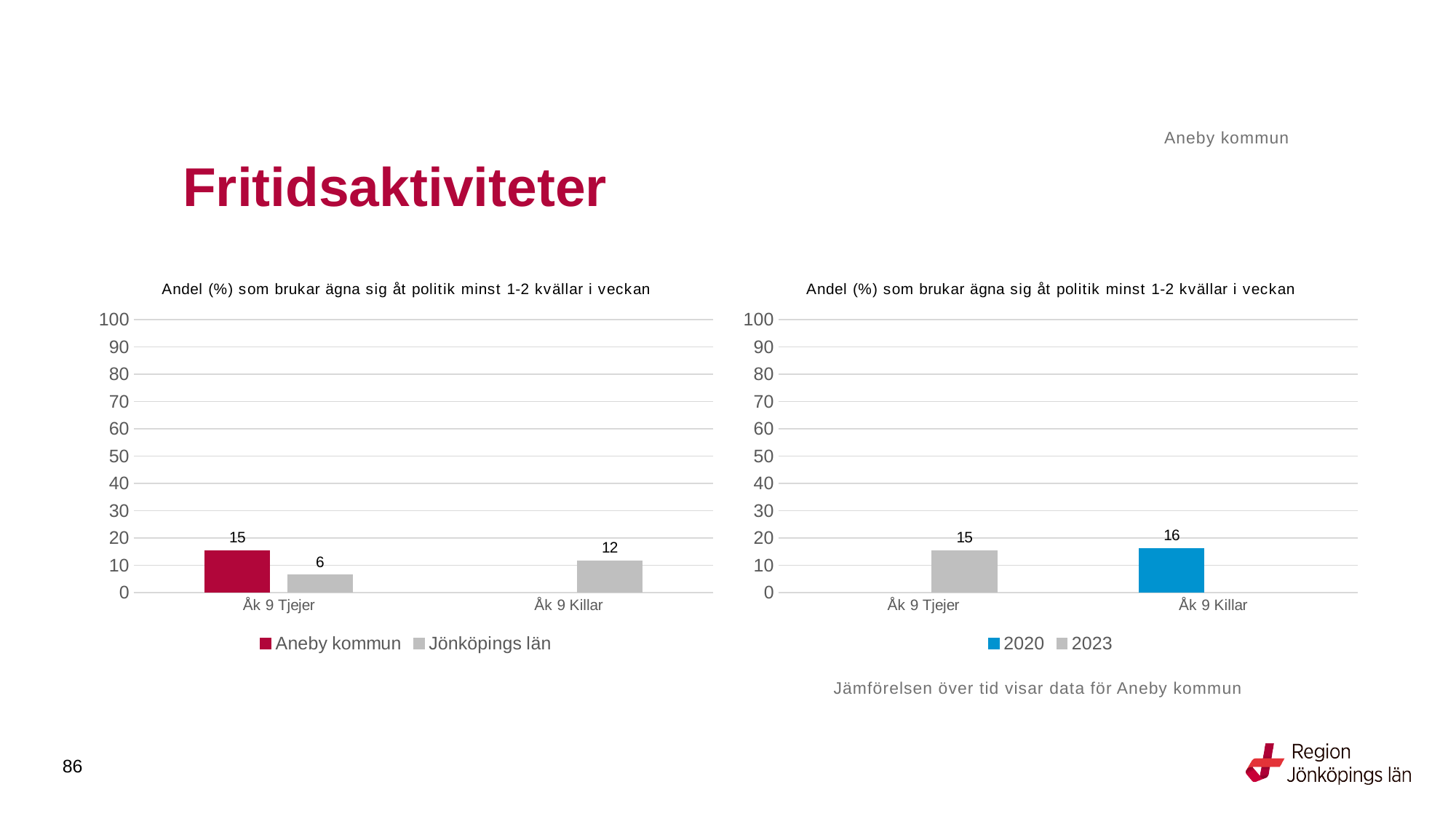
In the left chart, which is larger for Åk 9 Tjejer: Aneby kommun or Jönköpings län? Aneby kommun In the left chart, what is the value for Aneby kommun for Åk 9 Tjejer? 15 In the right chart, what is the value for 2023 for Åk 9 Tjejer? 15 What kind of chart is the right chart? bar chart In the right chart, what is the value for 2020 for Åk 9 Killar? 16 In the left chart, what is the value for Jönköpings län for Åk 9 Killar? 12 In the left chart, how many series does the legend list? 2 In the left chart, what is the value for Jönköpings län for Åk 9 Tjejer? 6 How many categories are shown on the x axis of the left chart? 2 In the right chart, is the value for 2020 for Åk 9 Killar greater or less than 20? less In the left chart, what is the difference between Aneby kommun and Jönköpings län for Åk 9 Tjejer? 9 What are the legend entries of the right chart? 2020 and 2023